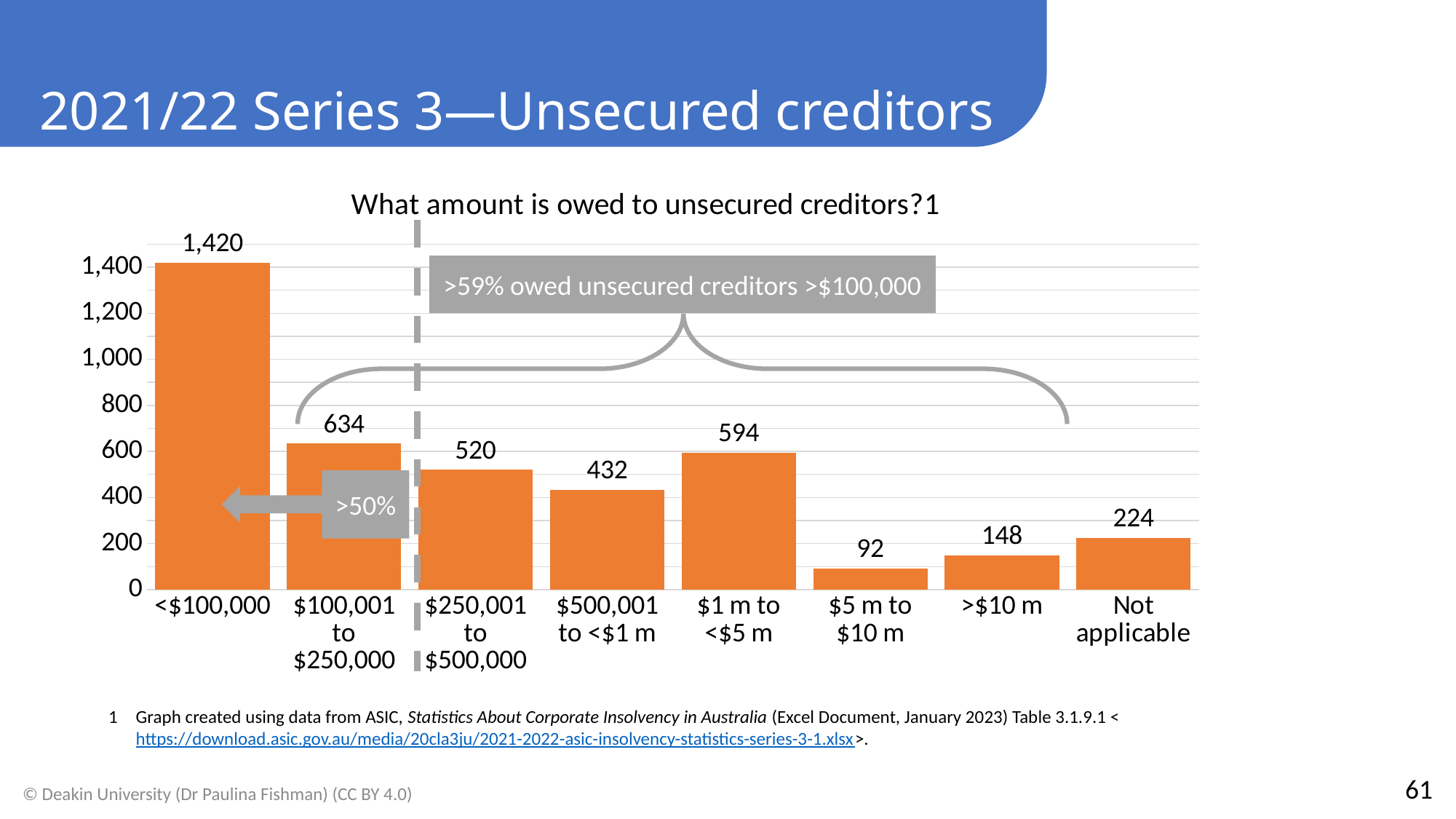
What is the value for the $1 m to <$5 m category? 594 What colour are the bars in the chart? orange Which category has the highest value? <$100,000 What is the value for the <$100,000 category? 1,420 What is the value for the Not applicable category? 224 Which category has the lowest value? $5 m to $10 m What is the difference between the values for $100,001 to $250,000 and $250,001 to $500,000? 114 What is the title of the chart? What amount is owed to unsecured creditors? How many categories are shown on the x axis? 8 What kind of chart is shown on the slide? bar chart Which is larger, the value for $500,001 to <$1 m or the value for $1 m to <$5 m? $1 m to <$5 m Is the value for >$10 m greater or less than 200? less